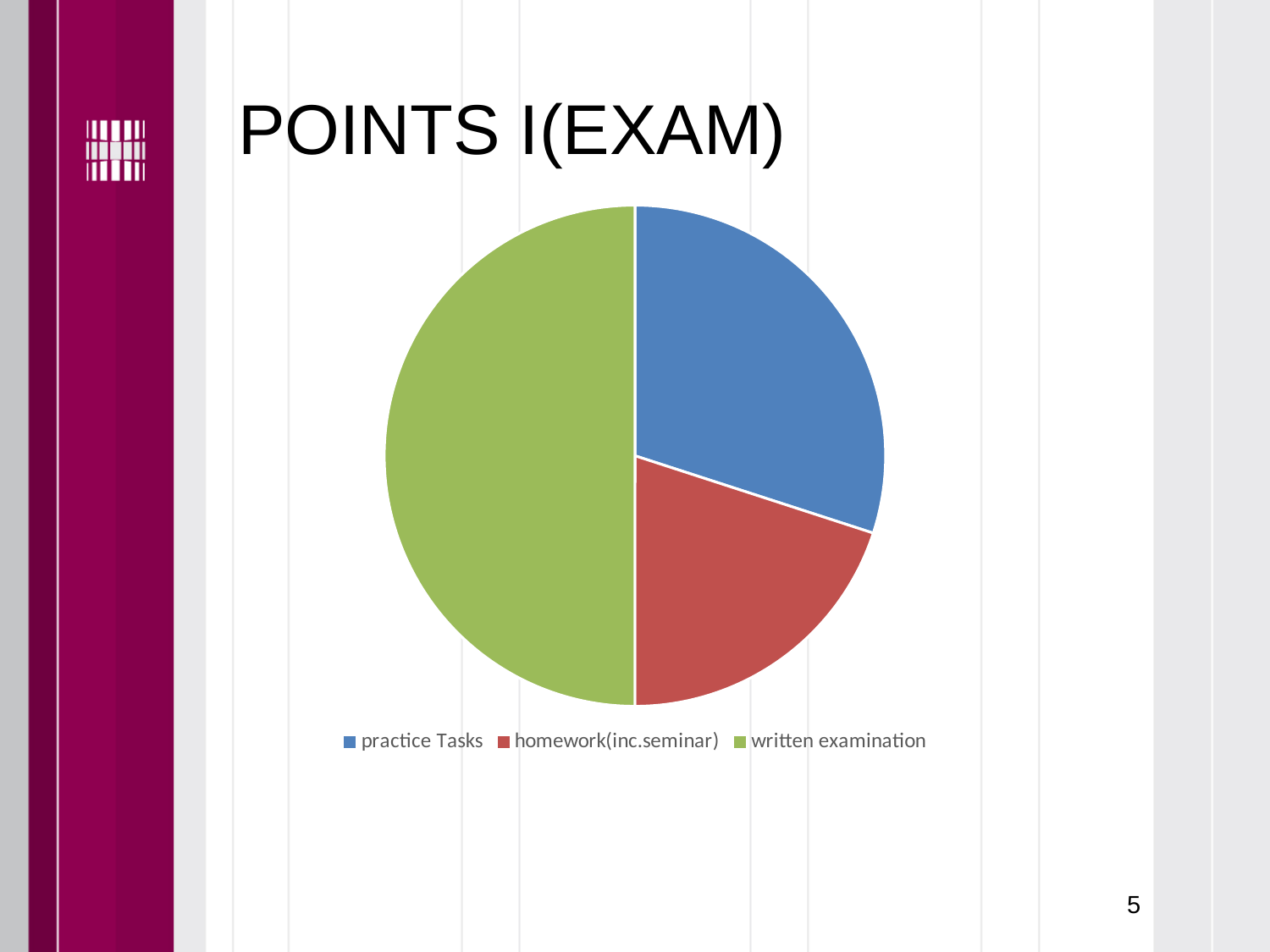
What kind of chart is shown on the slide? pie chart Which slice is larger, written examination or homework(inc.seminar)? written examination How many entries does the legend of the pie chart list? 3 Which category is shown in blue in the pie chart? practice Tasks Which category has the smallest slice of the pie chart? homework(inc.seminar) How many slices does the pie chart have? 3 Which slice is larger, practice Tasks or homework(inc.seminar)? practice Tasks Which category has the largest slice of the pie chart? written examination Which slice is larger, written examination or practice Tasks? written examination What colour is the written examination slice in the pie chart? green